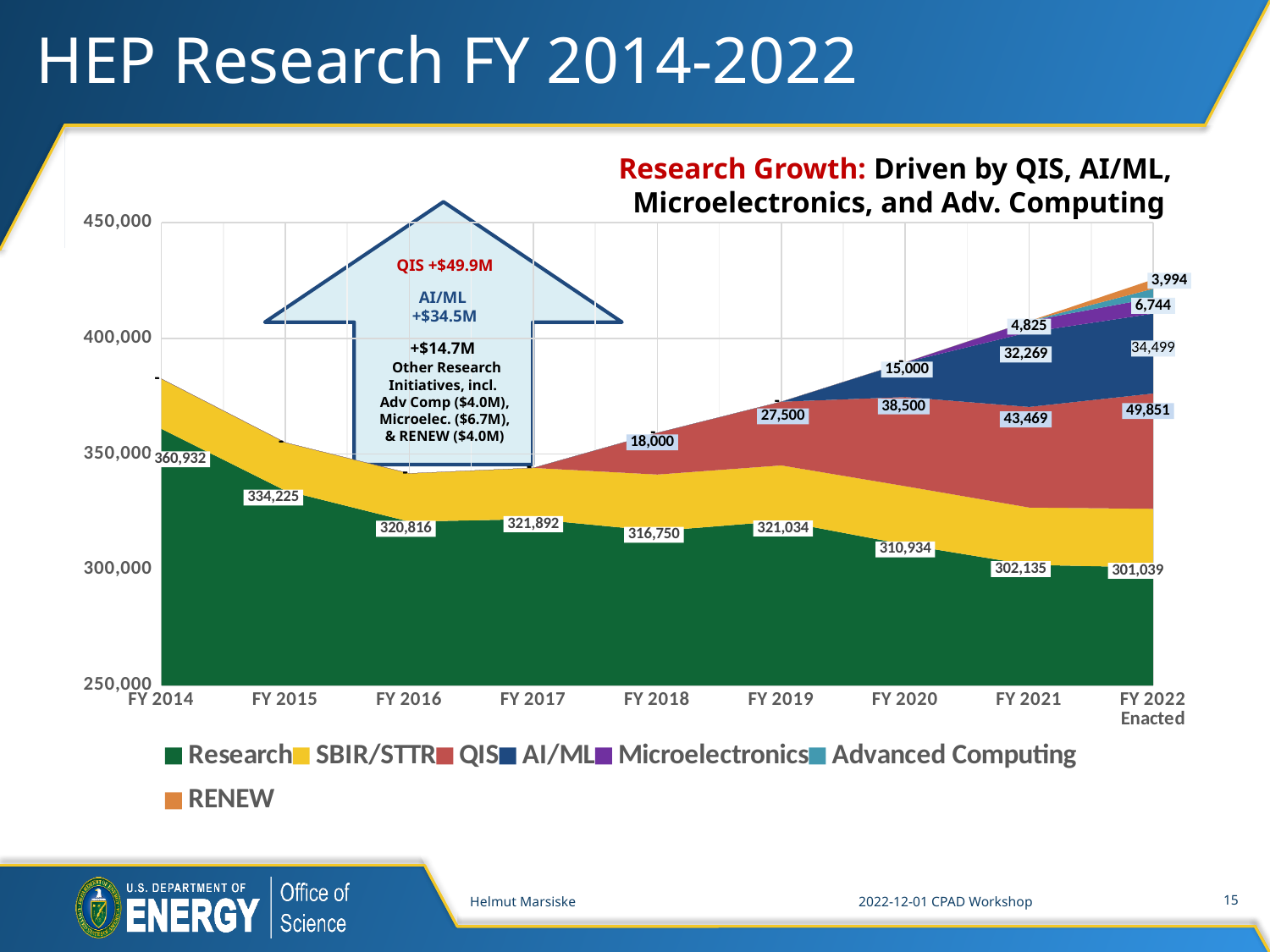
What is the value of the Research series for FY 2014? 360,932 What is the Microelectronics value for FY 2021? 4,825 Which is larger in FY 2021, the AI/ML value or the Microelectronics value? AI/ML Does the Research series rise or fall from FY 2014 to FY 2022? fall How many series does the legend list? 7 By how much did the QIS value increase from FY 2018 to FY 2022 Enacted? 31,851 What is the value of the Research series for FY 2022 Enacted? 301,039 What is the QIS value for FY 2018? 18,000 What is the difference between the Research value in FY 2014 and in FY 2022 Enacted? 59,893 In which fiscal year is the Research series highest? FY 2014 What is the AI/ML value for FY 2020? 15,000 In which fiscal year is the Research series lowest? FY 2022 Enacted